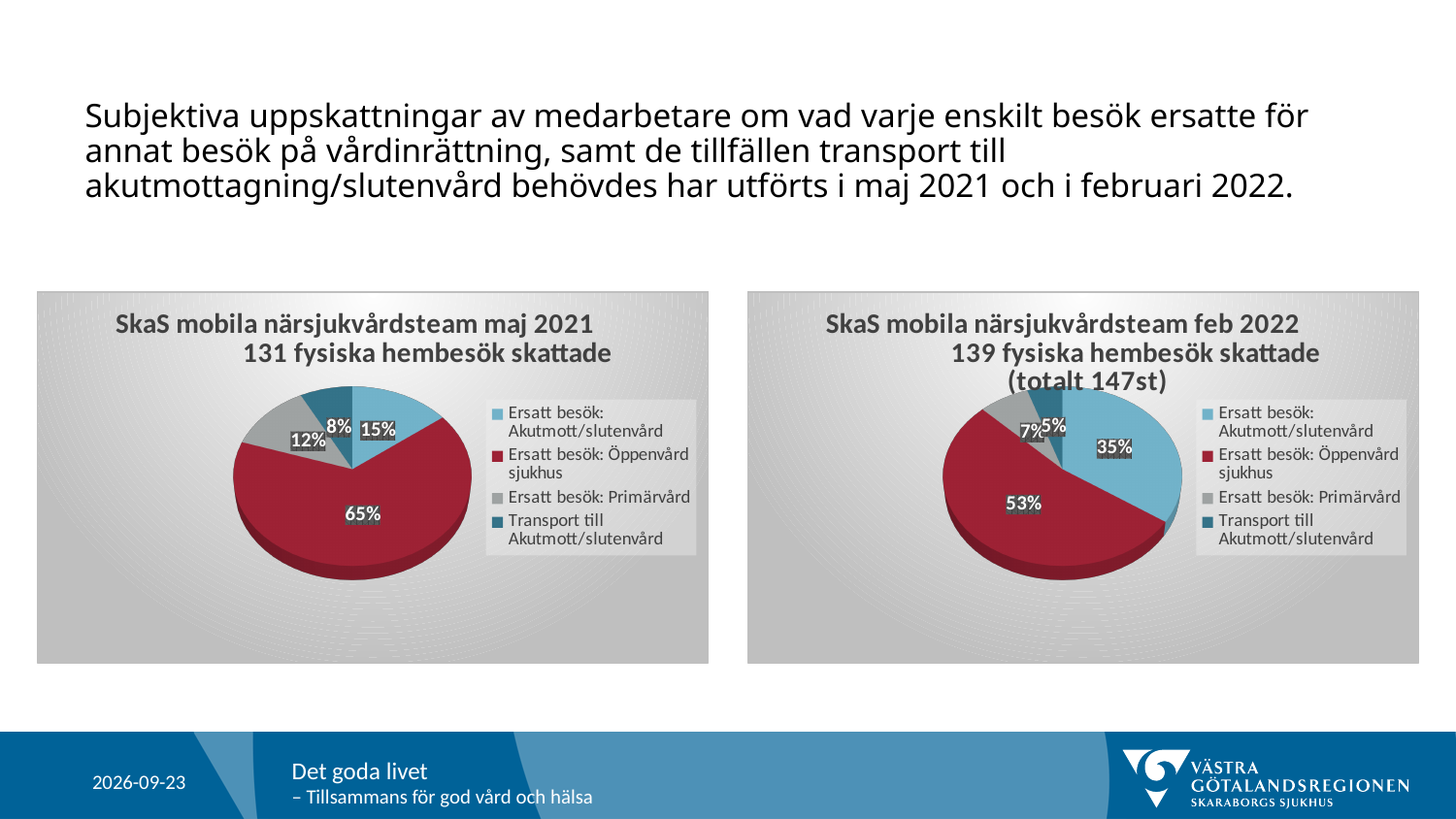
In the 'SkaS mobila närsjukvårdsteam feb 2022' chart, what share is 'Ersatt besök: Akutmott/slutenvård'? 35% In the 'SkaS mobila närsjukvårdsteam maj 2021' chart, what share is 'Ersatt besök: Akutmott/slutenvård'? 15% What is the difference between the 'Ersatt besök: Öppenvård sjukhus' share in the maj 2021 chart and in the feb 2022 chart? 12 percentage points In the 'SkaS mobila närsjukvårdsteam maj 2021' chart, which category has the largest slice? Ersatt besök: Öppenvård sjukhus In the 'SkaS mobila närsjukvårdsteam feb 2022' chart, which category has the smallest slice? Transport till Akutmott/slutenvård Which chart has the larger share for 'Ersatt besök: Akutmott/slutenvård', maj 2021 or feb 2022? feb 2022 In the 'SkaS mobila närsjukvårdsteam maj 2021' chart, what share is 'Ersatt besök: Öppenvård sjukhus'? 65% How many categories does the legend of the 'SkaS mobila närsjukvårdsteam maj 2021' chart list? 4 What type of chart is the 'SkaS mobila närsjukvårdsteam feb 2022' chart? Pie chart